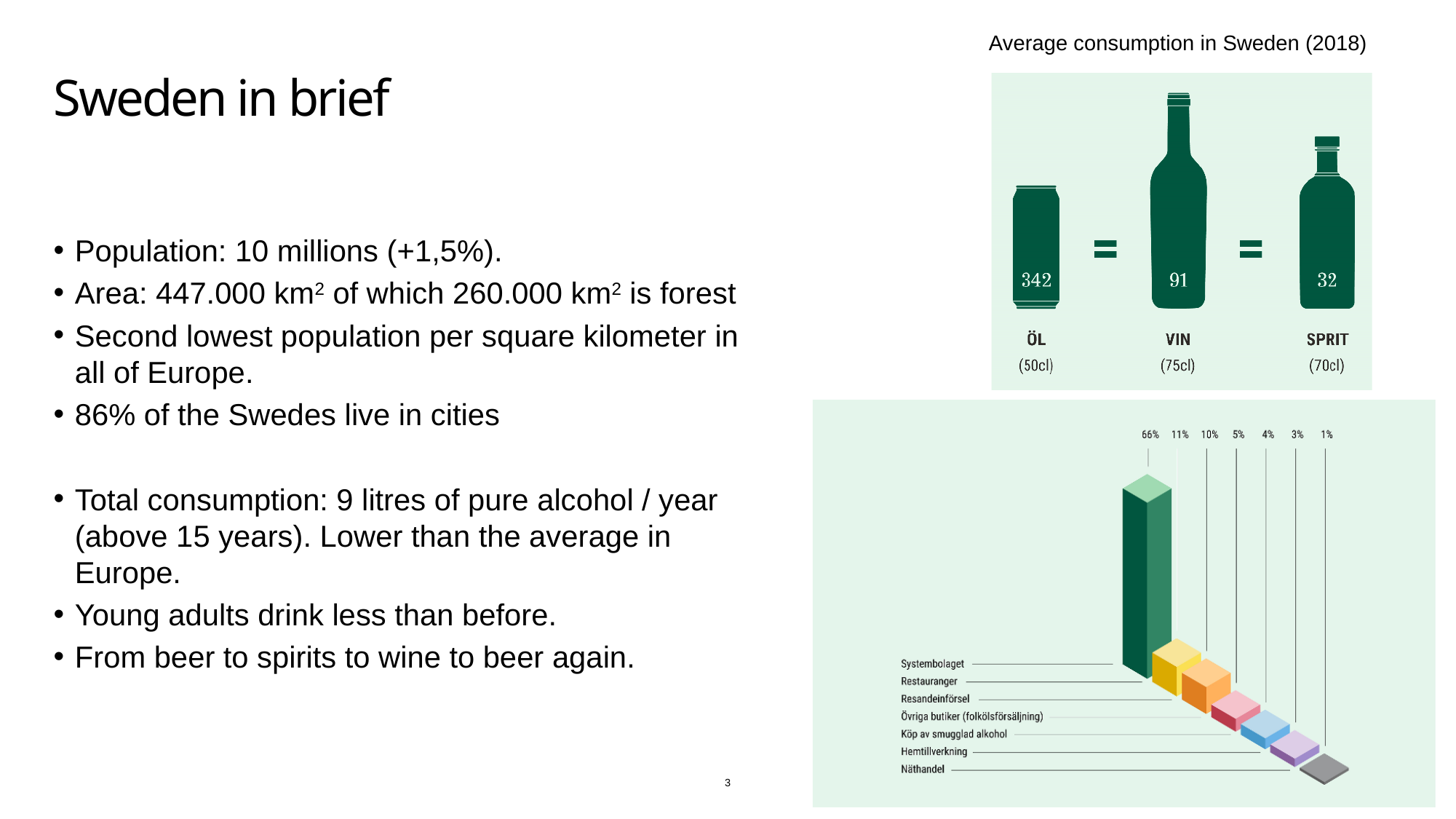
In the bar chart at the bottom right, what percentage is shown for Systembolaget? 66% In the bar chart at the bottom right, what is the difference between the values for Restauranger and Resandeinförsel? 1% In the 'Average consumption in Sweden (2018)' chart, what bottle size is given for VIN? 75cl In the bar chart at the bottom right, how many categories are listed? 7 In the bar chart at the bottom right, what percentage is shown for Näthandel? 1% In the bar chart at the bottom right, which category has the lowest value? Näthandel In the 'Average consumption in Sweden (2018)' chart, how many categories are shown? 3 In the 'Average consumption in Sweden (2018)' chart, what is the value shown for ÖL? 342 In the 'Average consumption in Sweden (2018)' chart, what is the value shown for SPRIT? 32 In the 'Average consumption in Sweden (2018)' chart, which category has the highest value? ÖL In the 'Average consumption in Sweden (2018)' chart, what is the value shown for VIN? 91 In the 'Average consumption in Sweden (2018)' chart, what is the difference between the values for ÖL and VIN? 251